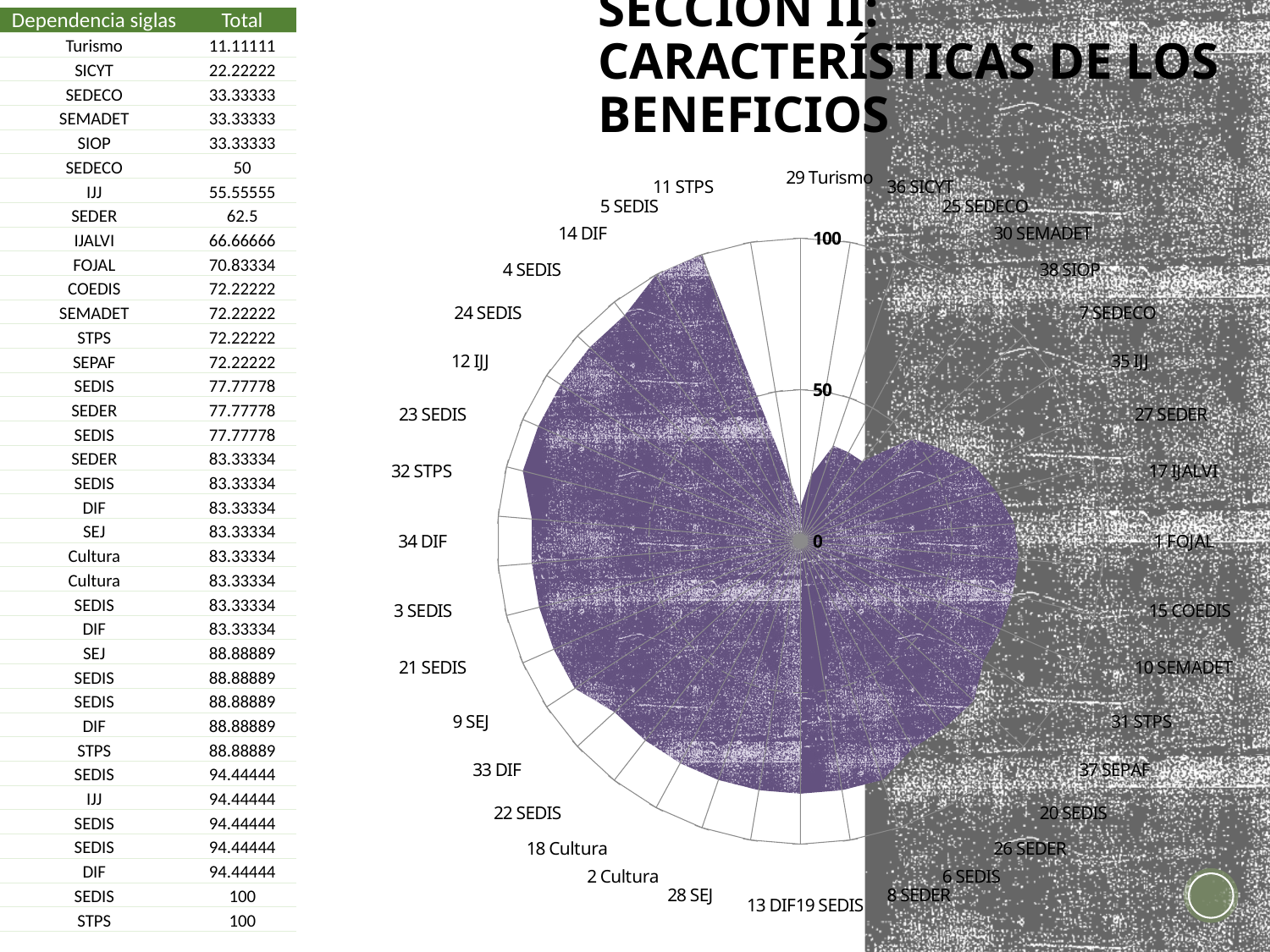
Which category has the lowest value on the radar chart? 29 Turismo Is the value for 34 DIF greater or less than 50? greater Which has the larger value, 36 SICYT or 15 COEDIS? 15 COEDIS Is the value for 3 SEDIS greater or less than 50? greater What is the highest value shown on the chart's radial axis? 100 Is the value for 29 Turismo greater or less than 50? less Which has the larger value, 29 Turismo or 34 DIF? 34 DIF What kind of chart is shown on the slide? Radar chart What colour is the filled area of the radar chart? Purple